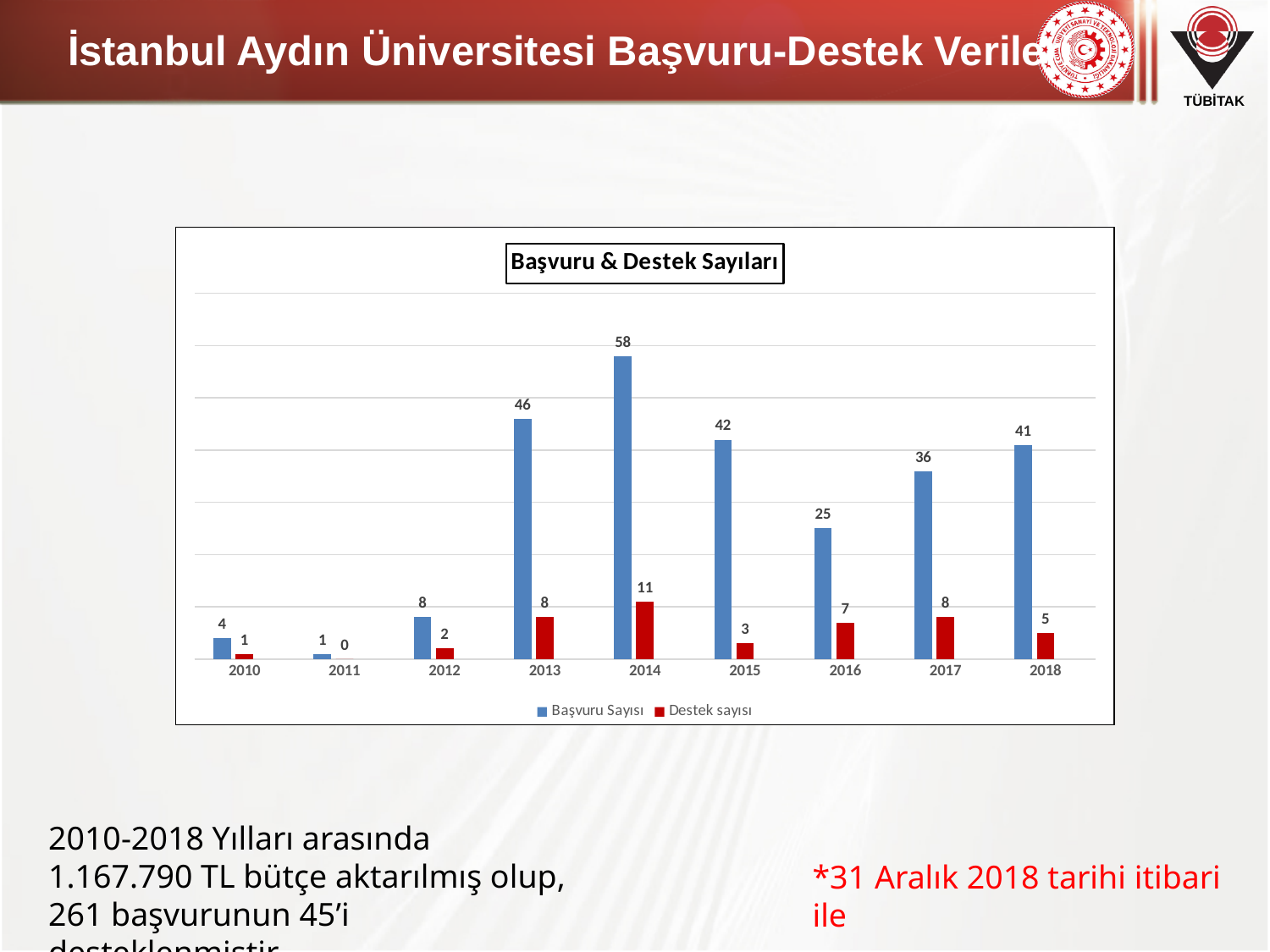
Which year has the lowest Destek sayısı? 2011 Which year has the highest Başvuru Sayısı? 2014 What is the Başvuru Sayısı value for 2014? 58 How many series does the legend list? 2 What is the difference between the Başvuru Sayısı for 2013 and 2015? 4 What is the title of the chart? Başvuru & Destek Sayıları What is the Destek sayısı value for 2016? 7 How many years are shown on the x axis? 9 Which colour represents Destek sayısı in the legend? red Does the Başvuru Sayısı rise or fall from 2014 to 2016? fall Which is larger, the Destek sayısı for 2014 or for 2017? 2014 What kind of chart is shown? bar chart